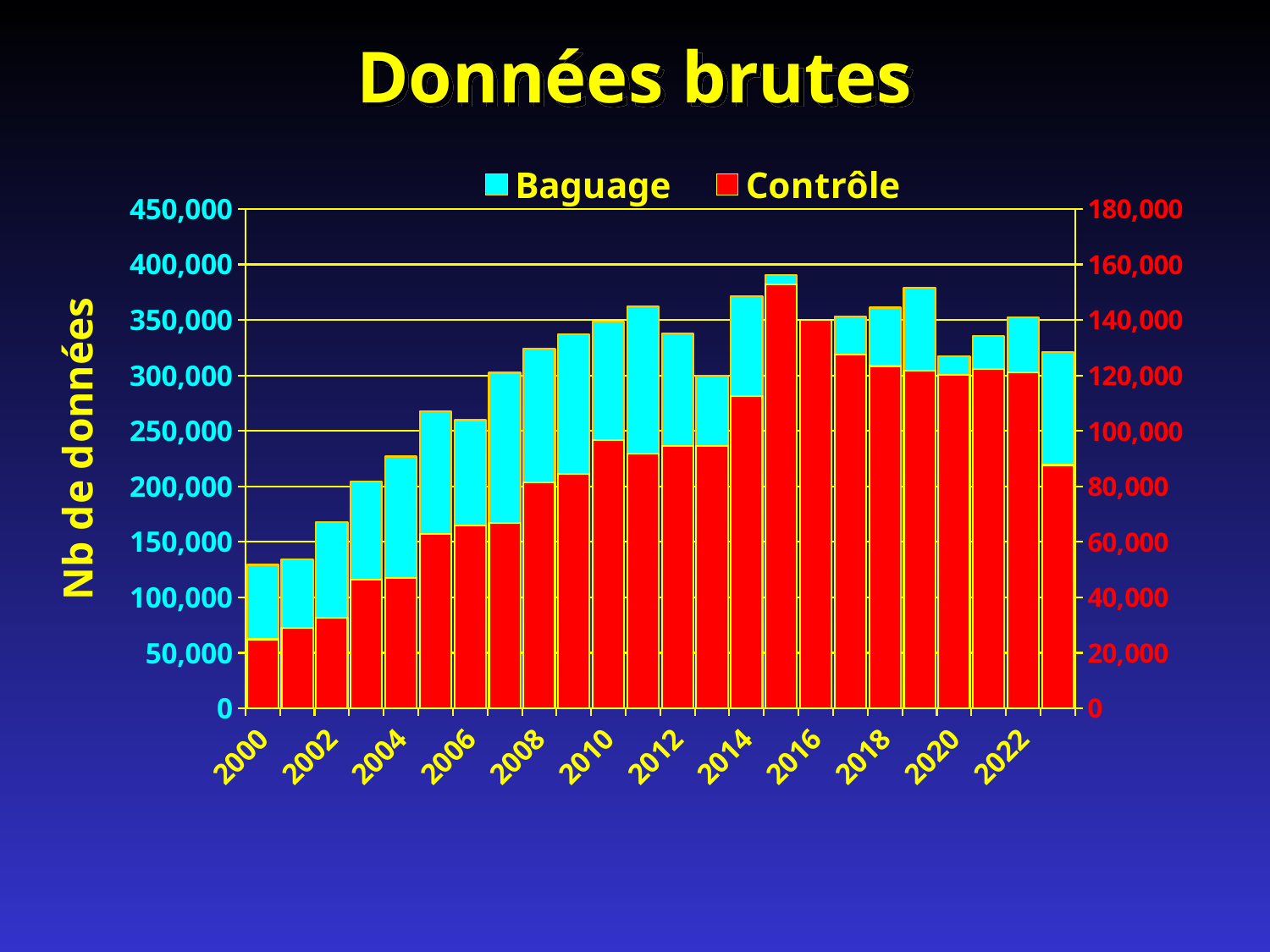
What is the title of the chart? Données brutes Is the Baguage value for 2015 greater or less than 350,000 on the left axis? greater What kind of chart is shown on the slide? bar chart Is the Baguage value for 2000 greater or less than 150,000 on the left axis? less Which year has the lowest Contrôle value? 2000 Is the Contrôle value for 2023 greater or less than 100,000 on the right axis? less How many years (bars) are plotted along the x axis? 24 Which year has the highest Contrôle value? 2015 How many series does the legend list? 2 What is the label on the left vertical axis? Nb de données Does the Contrôle value generally rise or fall from 2000 to 2015? rise